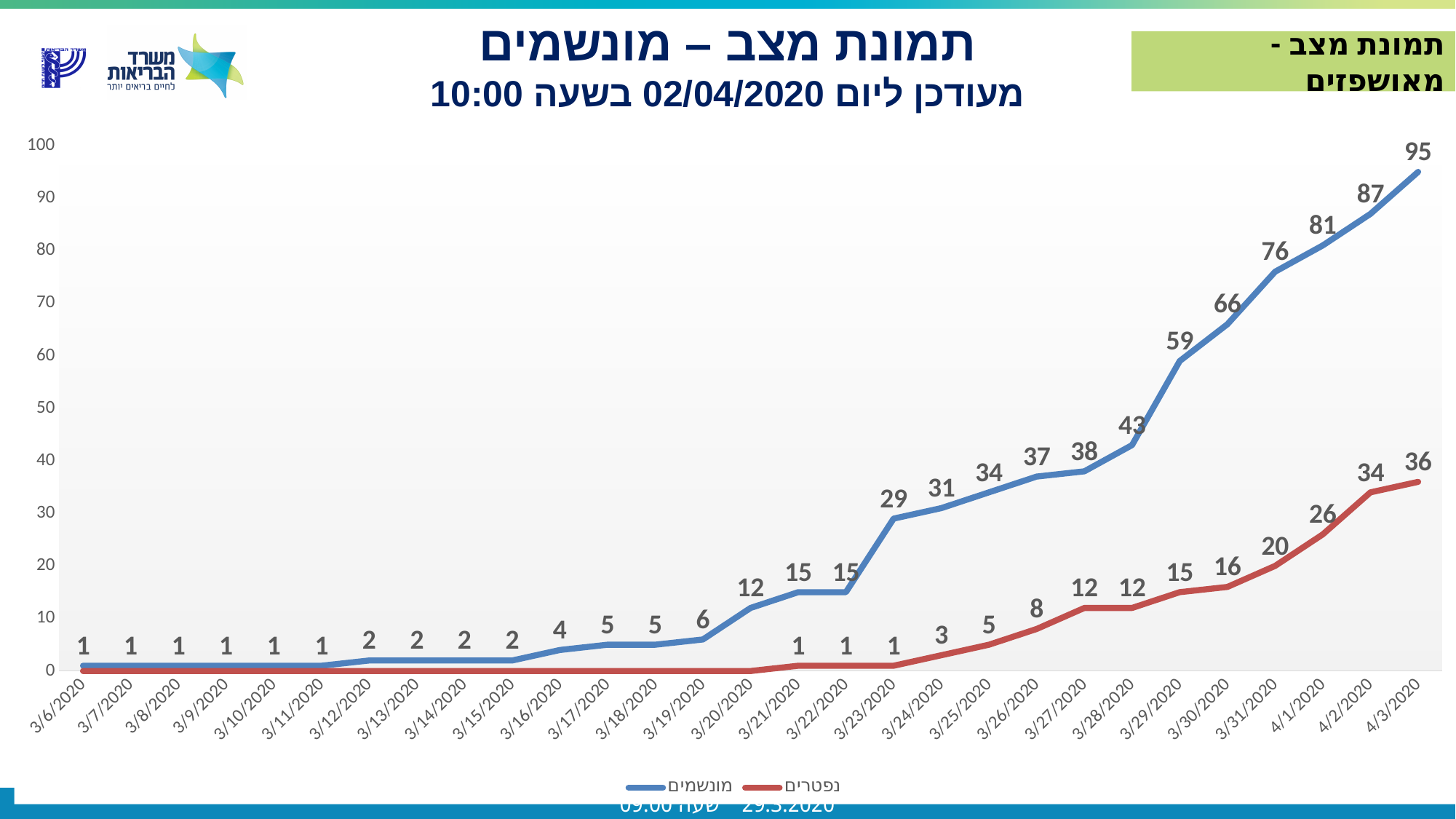
What is the difference between the מונשמים and נפטרים values on 4/3/2020? 59 By how much did the מונשמים value increase from 3/28/2020 to 3/29/2020? 16 How many dates are plotted along the x axis? 29 Which series has the higher value on 3/31/2020, מונשמים or נפטרים? מונשמים On which date does the מונשמים series reach its highest value? 4/3/2020 How many series does the legend list? 2 Does the מונשמים series rise or fall from 3/6/2020 to 4/3/2020? rise What is the value of the מונשמים series on 4/3/2020? 95 What is the value of the נפטרים series on 3/29/2020? 15 What is the value of the נפטרים series on 4/3/2020? 36 What type of chart is shown on the slide? line chart What is the value of the מונשמים series on 3/23/2020? 29